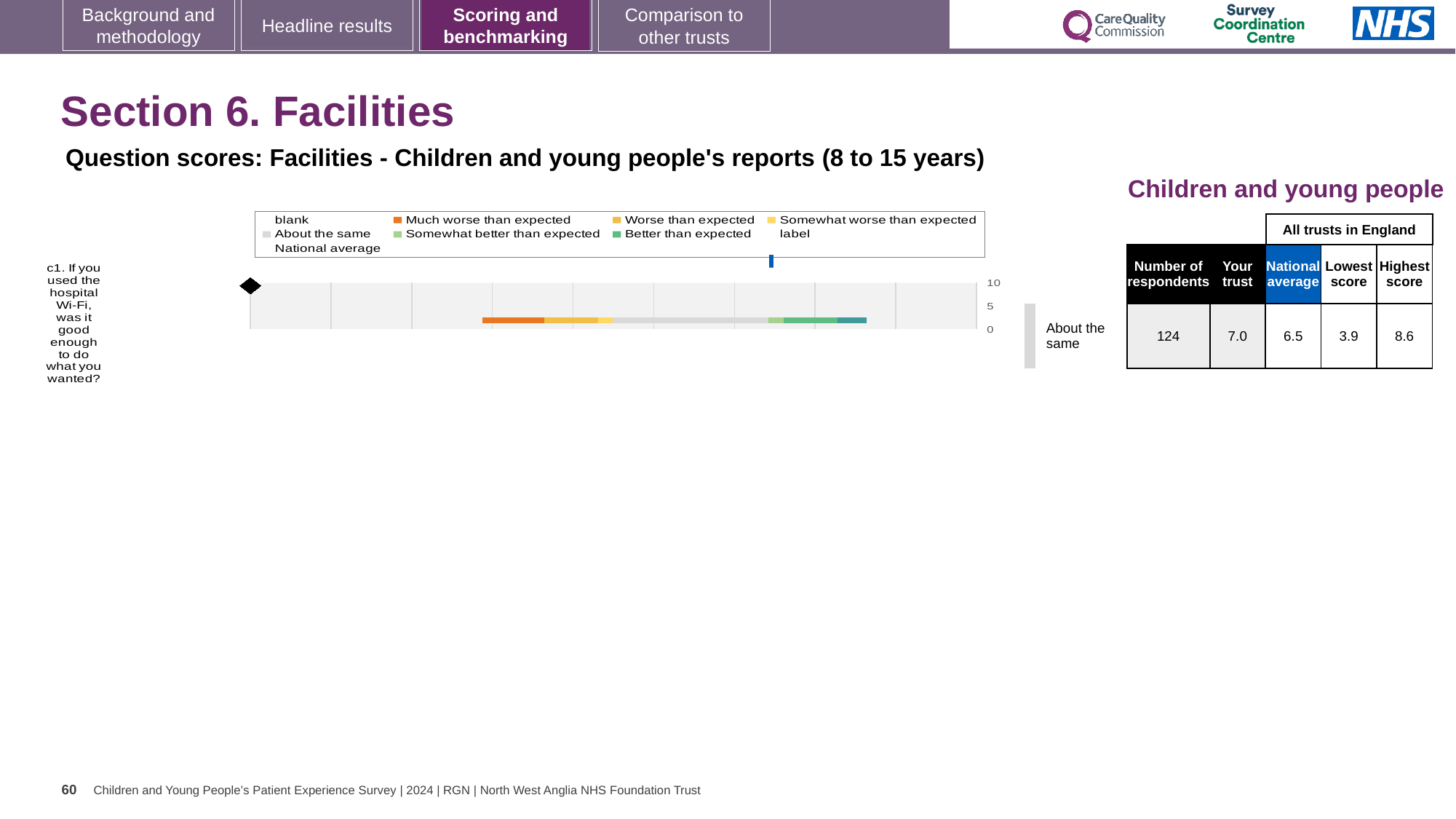
What is the national average score for question c1 about the hospital Wi-Fi? 6.5 By how much does the 'Your trust' score exceed the national average for question c1? 0.5 What is the highest score among all trusts in England for question c1? 8.6 What is the difference between the highest score and the lowest score for question c1? 4.7 How many survey questions are plotted in the chart? 1 What is the lowest score among all trusts in England for question c1? 3.9 What colour represents 'Much worse than expected' in the chart legend? orange For question c1, which is higher: the 'Your trust' score or the national average? Your trust What is the 'Your trust' score for question c1 about the hospital Wi-Fi? 7.0 What kind of chart is shown on the slide? bar chart How many respondents answered question c1 about the hospital Wi-Fi? 124 What benchmark category is shown next to the chart for question c1? About the same